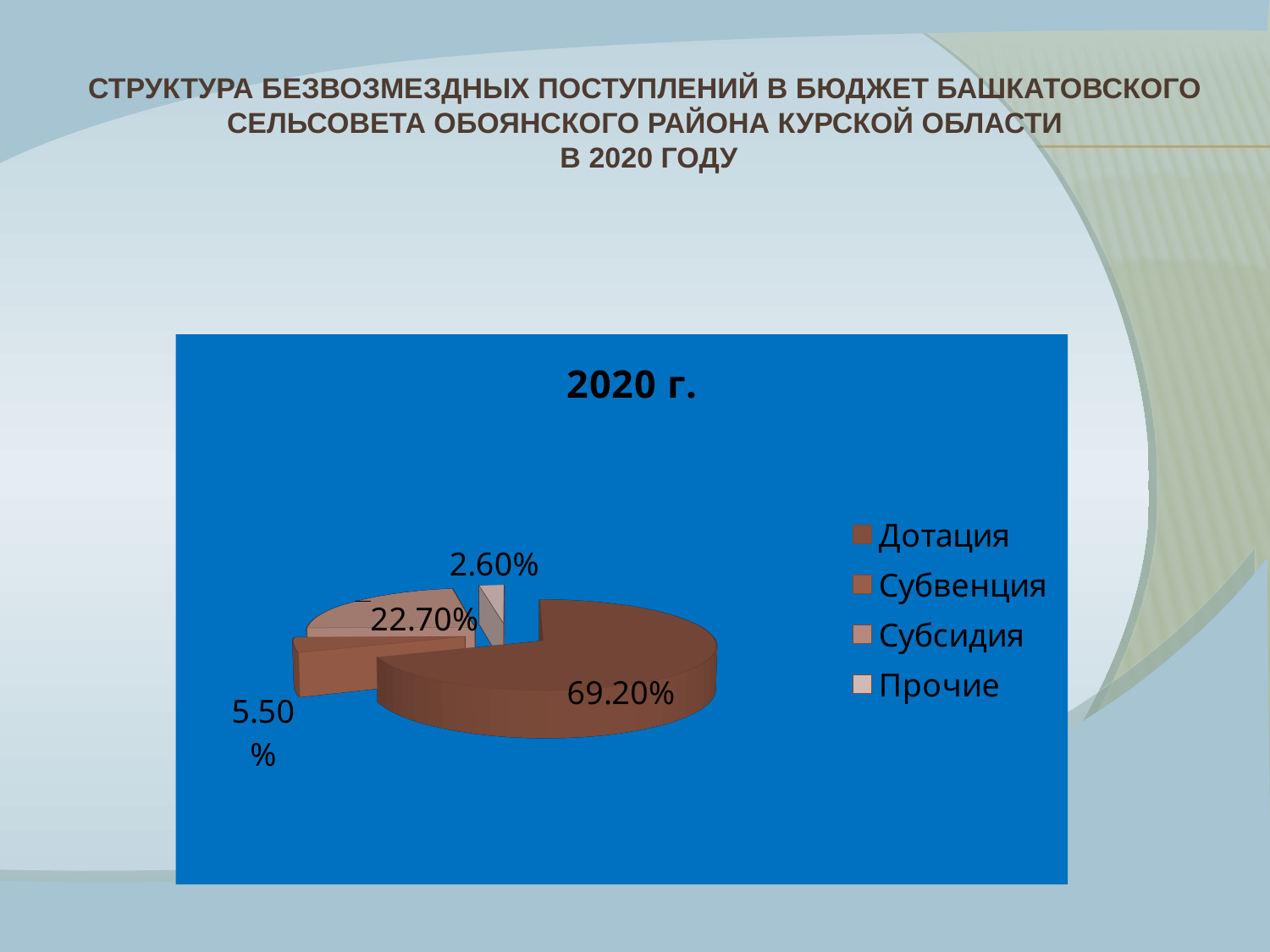
What is the difference between the shares of Дотация and Субсидия? 46.50% What share of the pie does Субсидия have? 22.70% What share of the pie does Субвенция have? 5.50% What type of chart is shown on the slide? pie chart Which category has the largest slice? Дотация How many slices does the pie chart have? 4 What is the title of the chart? 2020 г. What share of the pie does Дотация have? 69.20% Which category has the smallest slice? Прочие Which is larger, the share of Субвенция or the share of Прочие? Субвенция How many entries does the legend list? 4